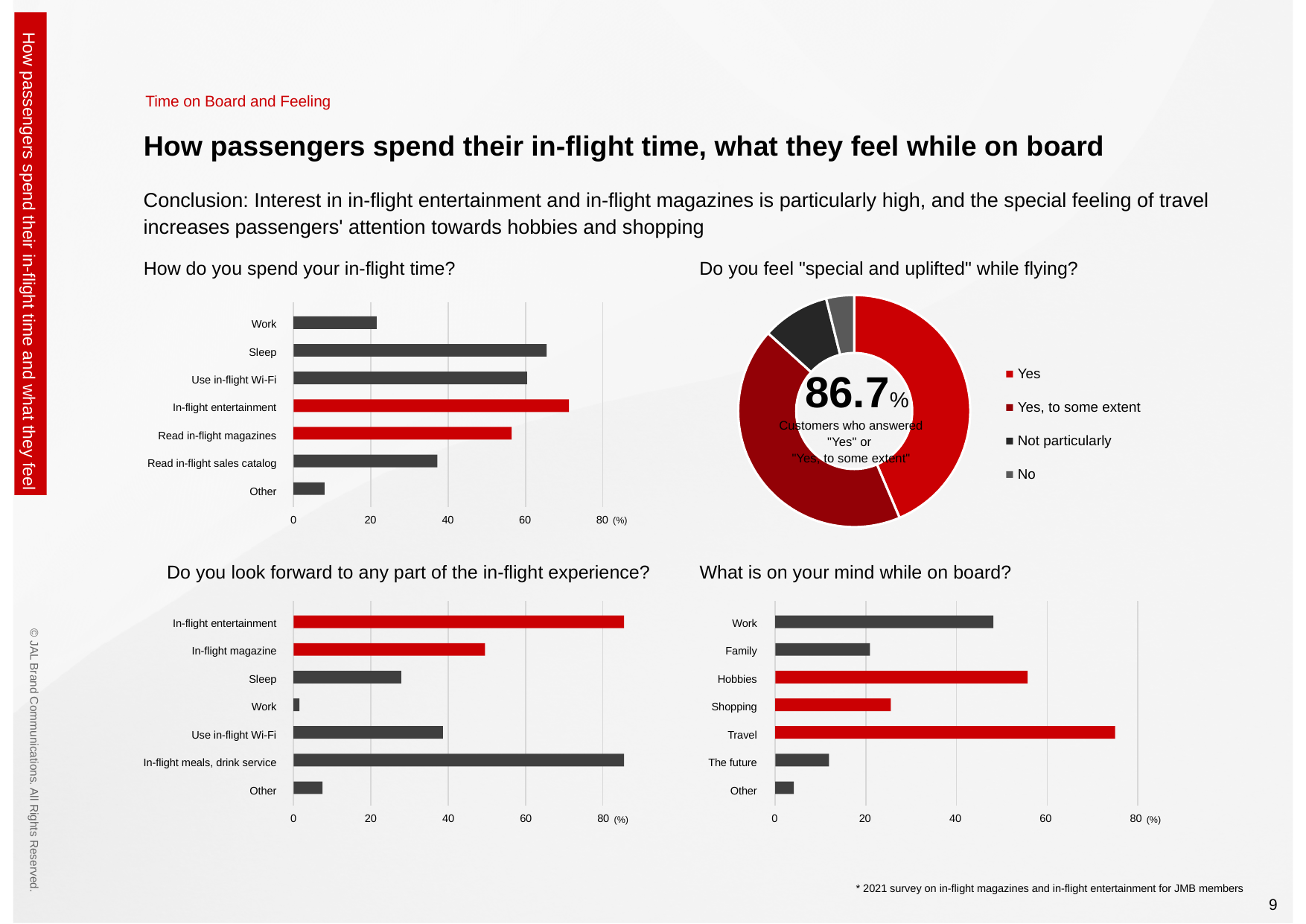
What type of chart is "How do you spend your in-flight time?"? bar chart In the chart "What is on your mind while on board?", which category has the highest value? Travel In the chart "What is on your mind while on board?", is the value for The future greater or less than 20? less In the chart "How do you spend your in-flight time?", which category has the highest value? In-flight entertainment In the chart "Do you look forward to any part of the in-flight experience?", is the value for In-flight magazine greater or less than 40? greater In the chart "What is on your mind while on board?", which is larger, Hobbies or Work? Hobbies How many categories are shown in the chart "How do you spend your in-flight time?"? 7 How many entries does the legend list in the chart "Do you feel "special and uplifted" while flying?"? 4 In the chart "Do you look forward to any part of the in-flight experience?", which category has the lowest value? Work In the chart "Do you feel "special and uplifted" while flying?", what percentage of customers answered "Yes" or "Yes, to some extent"? 86.7% In the chart "How do you spend your in-flight time?", which category has the lowest value? Other In the chart "How do you spend your in-flight time?", is the value for Sleep greater or less than 60? greater